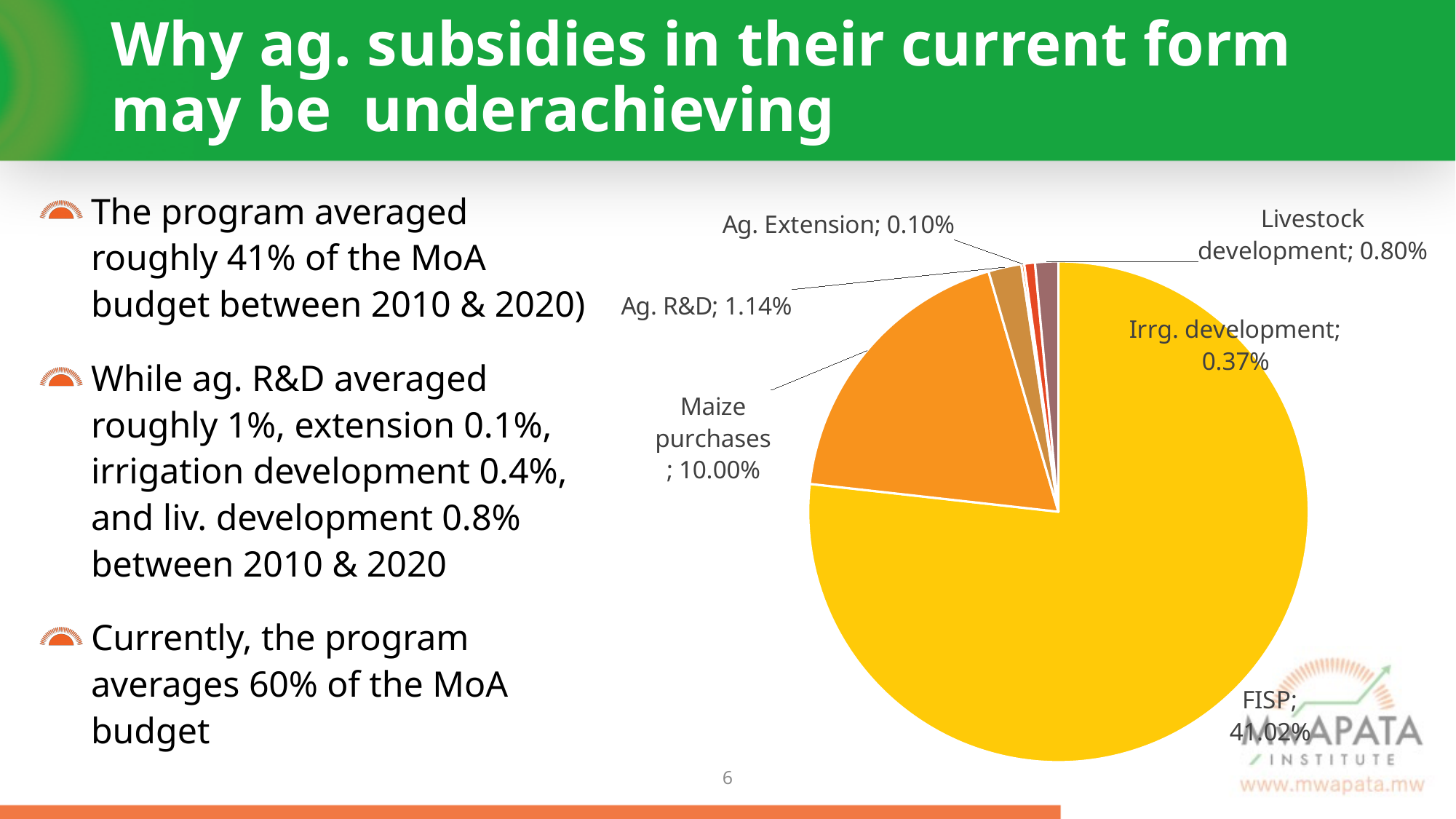
Which is larger, the value for Livestock development or the value for Irrg. development? Livestock development What value is shown for Ag. R&D in the pie chart? 1.14% What value is shown for Livestock development in the pie chart? 0.80% What value is shown for Ag. Extension in the pie chart? 0.10% What value is shown for FISP in the pie chart? 41.02% What kind of chart is shown on the slide? pie chart What value is shown for Irrg. development in the pie chart? 0.37% Which category has the smallest slice in the pie chart? Ag. Extension What is the difference between the values for FISP and Maize purchases? 31.02% How many categories are shown in the pie chart? 6 Which category has the largest slice in the pie chart? FISP What value is shown for Maize purchases in the pie chart? 10.00%